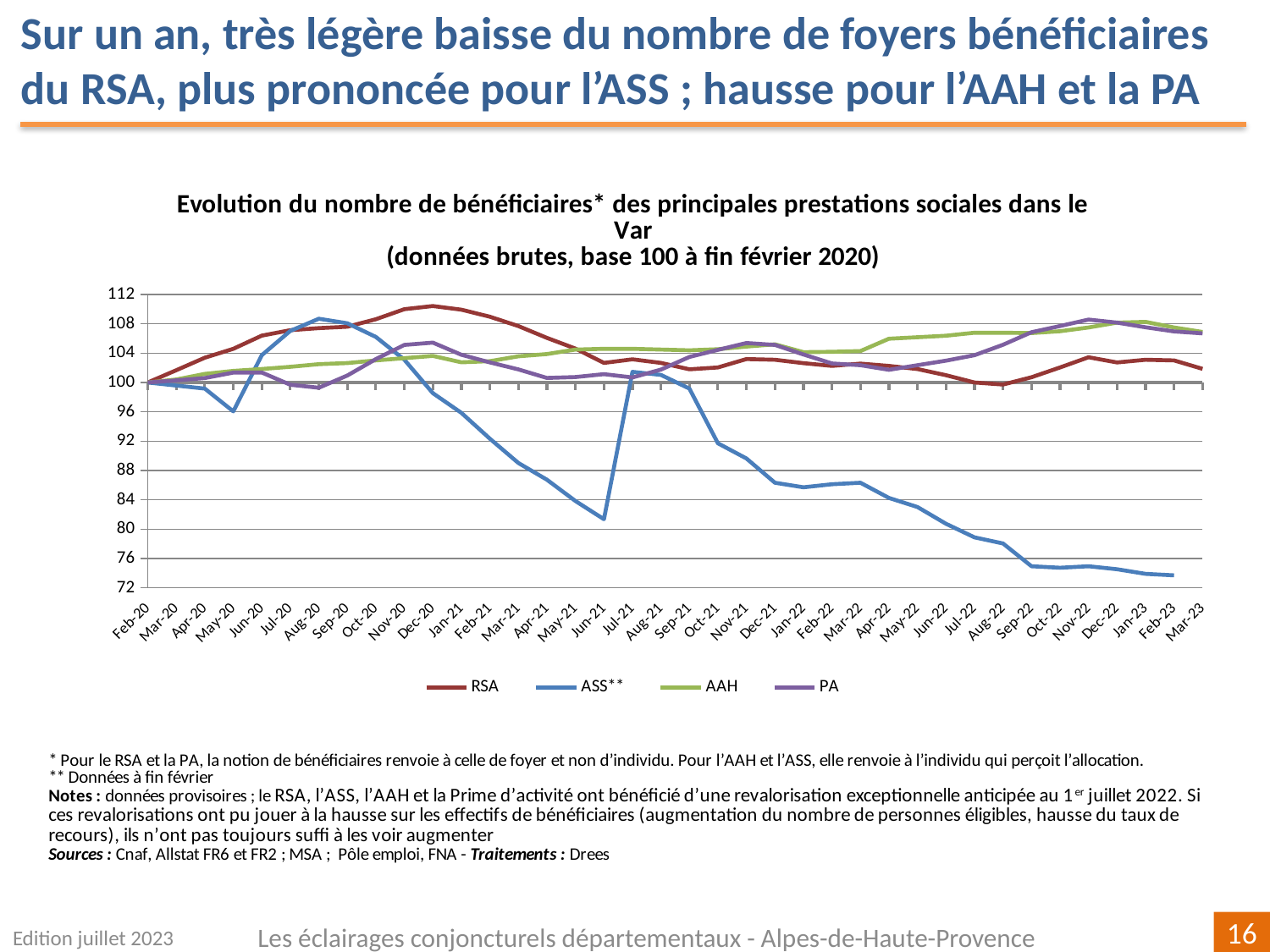
What is the base period of the index (base 100) according to the chart title? fin février 2020 Is the value for ASS** in Jun-21 greater or less than 84? less Which series has the lowest value in Mar-23? RSA In Mar-23, which series is higher, RSA or AAH? AAH Does the ASS** series rise or fall between Sep-21 and Feb-23? fall Is the value for AAH in Mar-23 greater or less than 104? greater Is the value for ASS** in Feb-23 greater or less than 76? less Which series are listed in the legend? RSA, ASS**, AAH, PA How many series does the legend list? 4 What kind of chart is shown on the slide? line chart